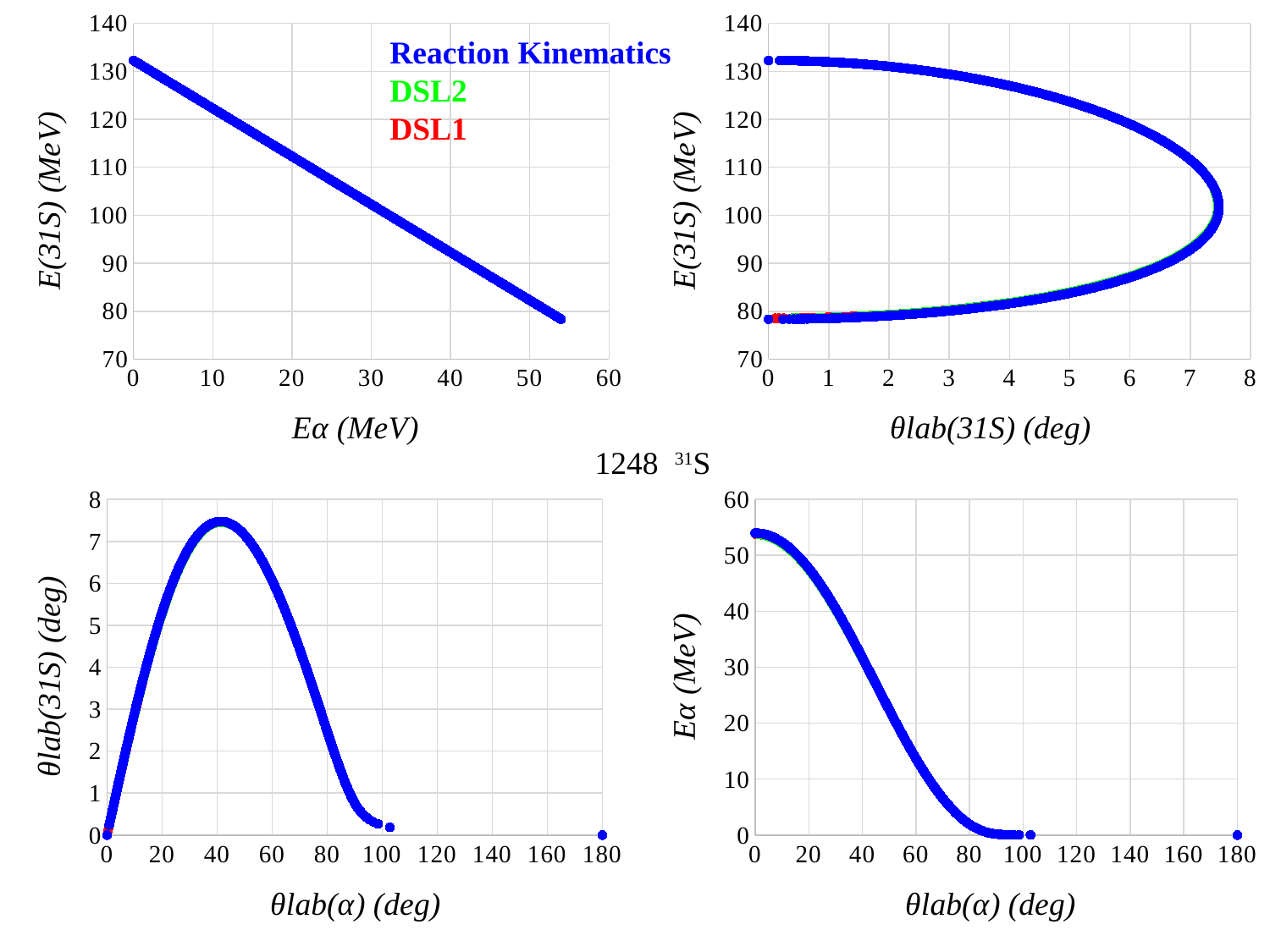
What kind of chart is the top-left plot of E(31S) versus Eα? scatter plot In the top-right chart, is the largest θlab(31S) reached by the curve greater or less than 8? less In the top-right chart, is the largest θlab(31S) reached by the curve greater or less than 7? greater In the bottom-right chart, do the Eα values rise or fall as θlab(α) increases from 0 to 80 degrees? fall In the top-left chart, is the value of E(31S) at Eα = 0 greater or less than 120? greater In the top-left chart, do the E(31S) values rise or fall as Eα increases? fall How many series does the legend list? 3 What colour is used for the Reaction Kinematics series in the legend? blue